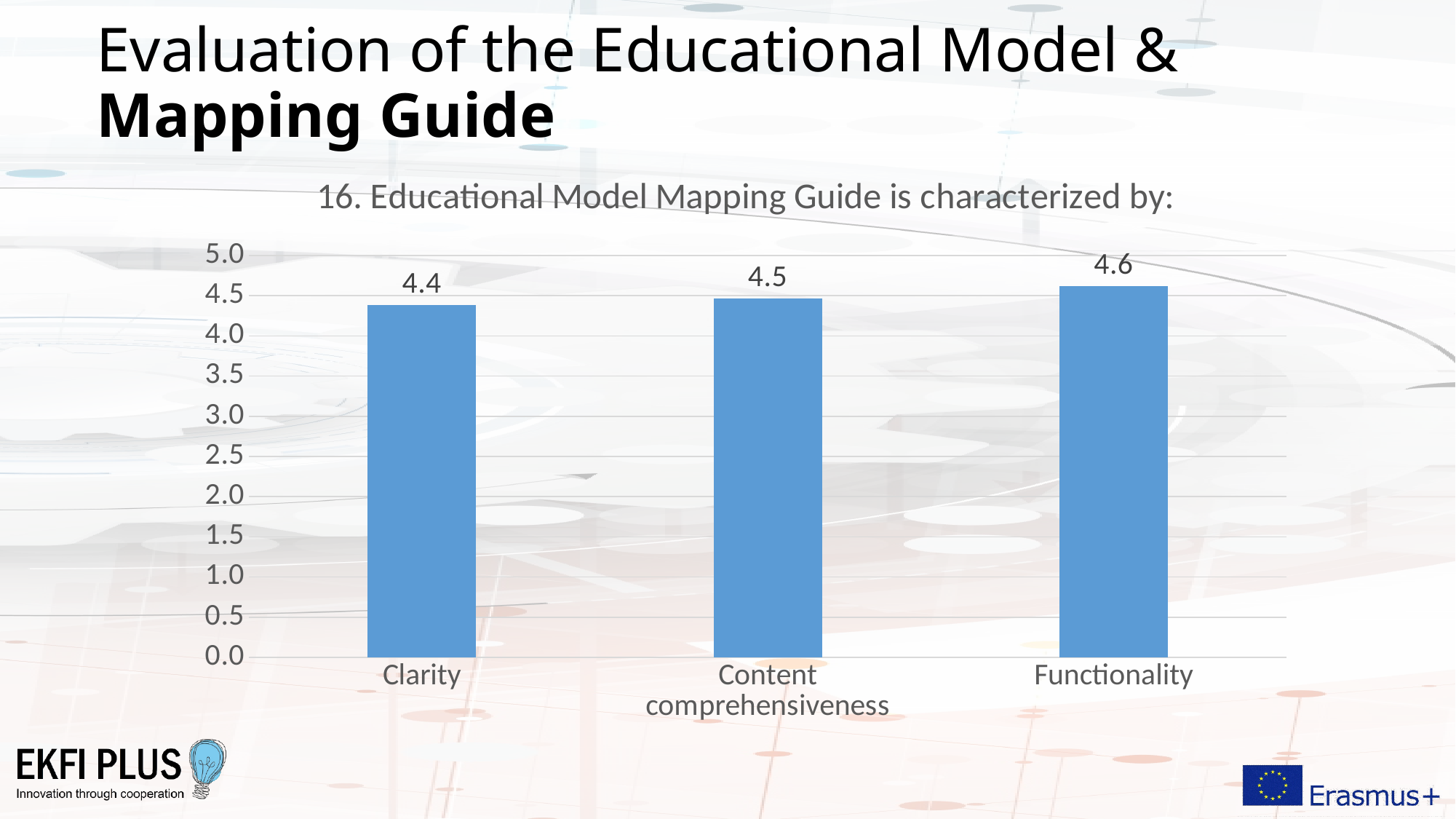
What is the difference between the values for Functionality and Clarity? 0.2 Which category has the lowest value? Clarity What is the title of the chart? 16. Educational Model Mapping Guide is characterized by: What is the value for Content comprehensiveness? 4.5 What is the value for Functionality? 4.6 Which category has the highest value? Functionality Which is larger, the value for Functionality or the value for Clarity? Functionality Is the value for Clarity greater or less than 4.0? greater What is the value for Clarity? 4.4 What is the difference between the values for Content comprehensiveness and Clarity? 0.1 How many categories are shown in the chart? 3 What kind of chart is shown on the slide? bar chart